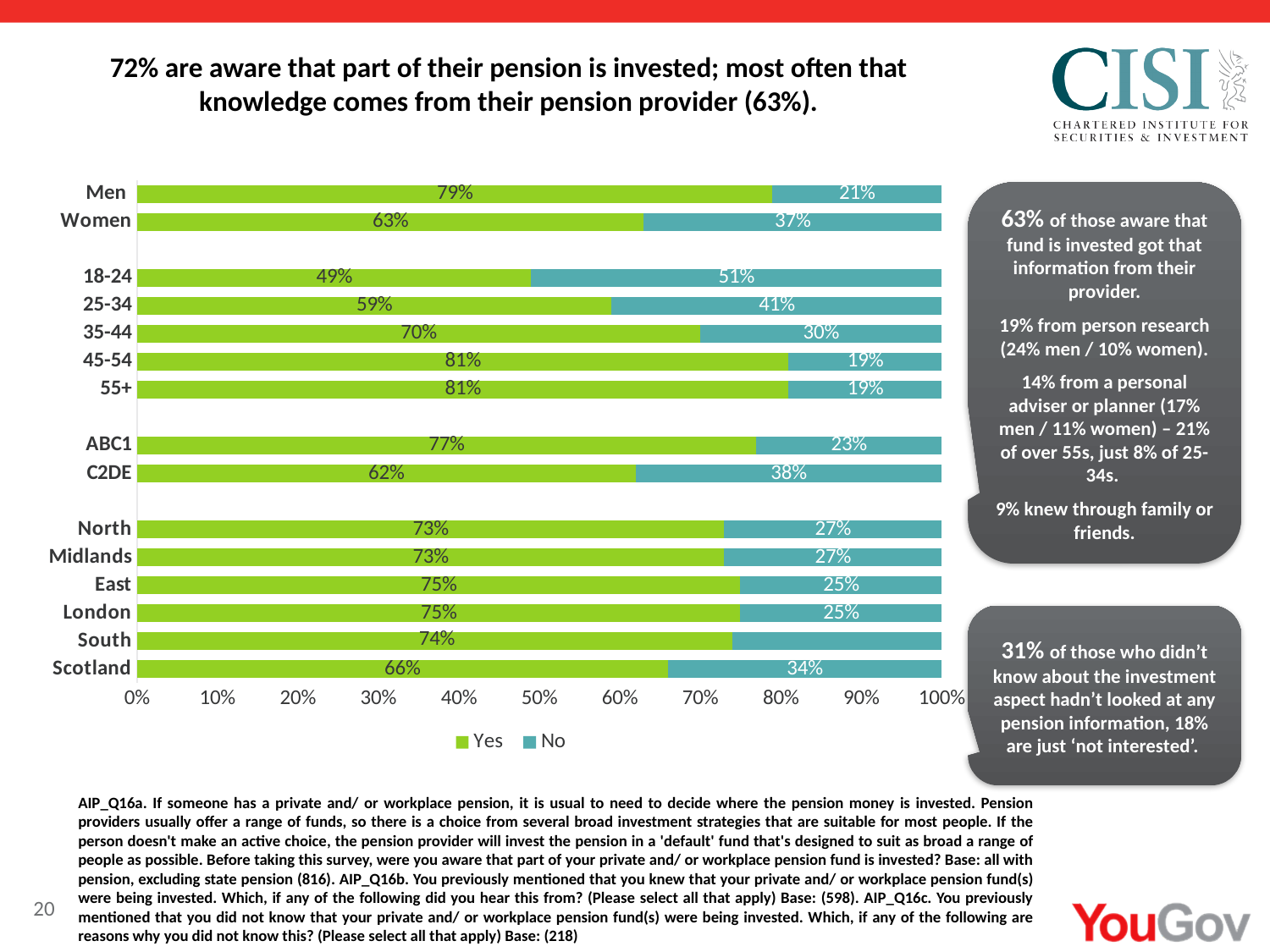
How many series does the legend list? 2 How many categories are shown on the chart? 15 Which category has the lowest Yes value? 18-24 What is the Yes value for Scotland? 66% Which has a larger Yes value, ABC1 or C2DE? ABC1 What percentage of C2DE respondents answered Yes? 62% How many percentage points higher is the Yes value for Men than for Women? 16 What type of chart is shown on the slide? Stacked bar chart Which category has the highest No value? 18-24 Is the No value for South greater or less than 30%? less What percentage of Men answered Yes? 79% What is the No value for the 18-24 age group? 51%